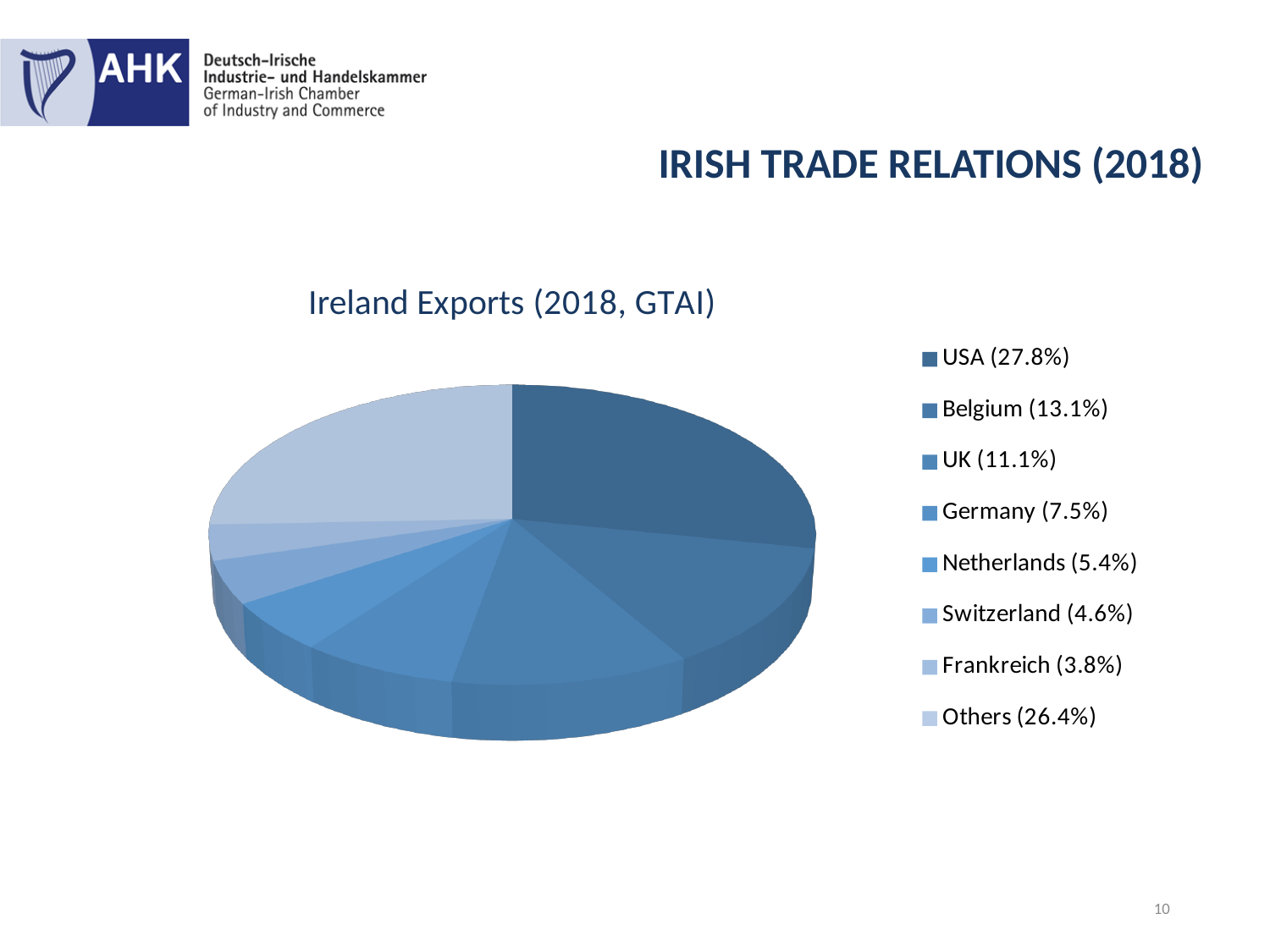
Which named country has the largest share of Ireland's exports? USA How many slices does the pie chart have? 8 What is the title of the chart? Ireland Exports (2018, GTAI) What share of Ireland's exports goes to Belgium? 13.1% Which category has the smallest share of Ireland's exports? Frankreich What is the difference in share between the USA and the UK? 16.7% What is the combined share of Germany and Switzerland? 12.1% What share of Ireland's exports goes to Germany? 7.5% Which has a larger share of Ireland's exports, Belgium or the Netherlands? Belgium What share of Ireland's exports is labelled as Others? 26.4% What share of Ireland's exports goes to the USA? 27.8% What type of chart is shown on the slide? Pie chart